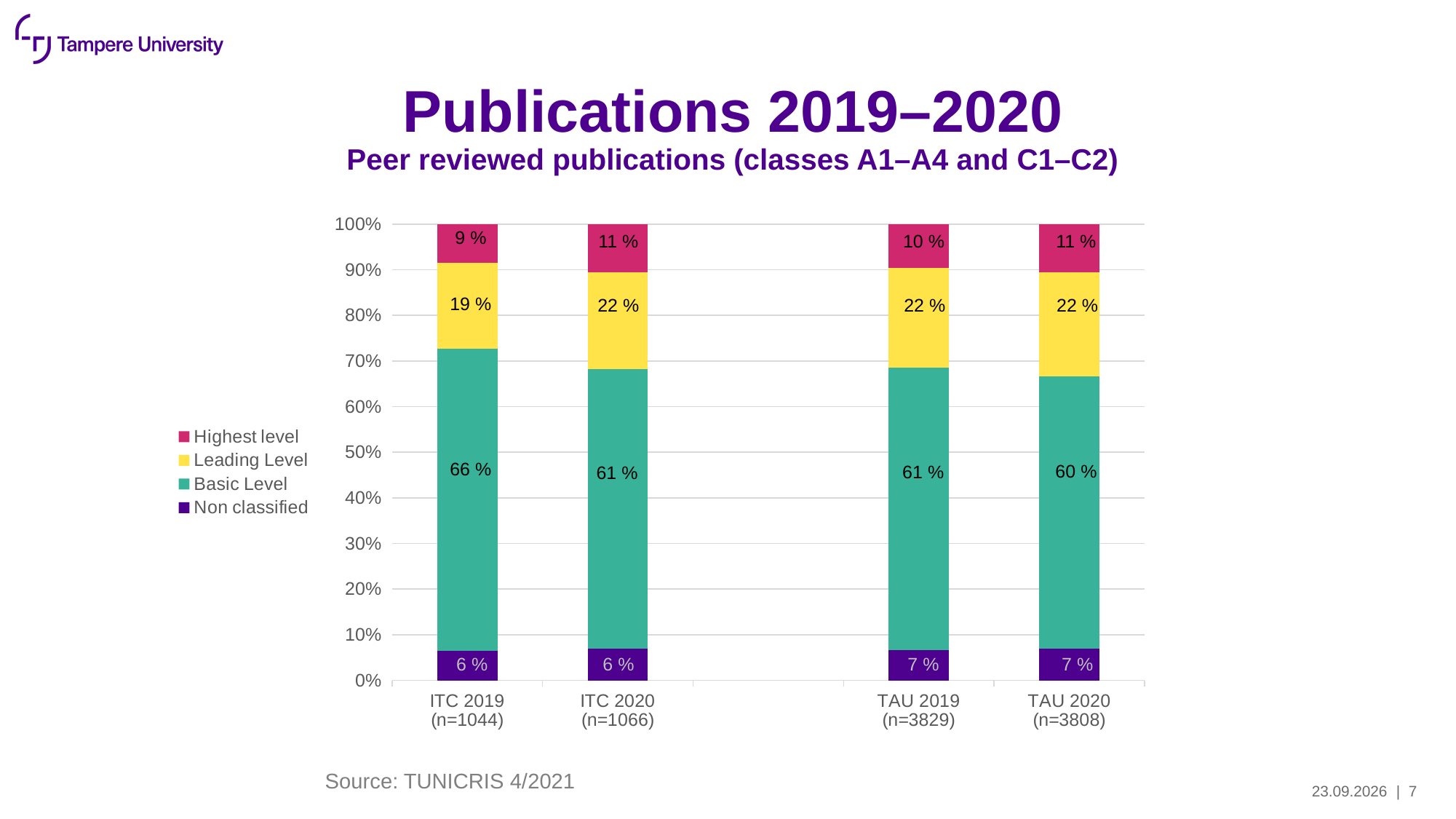
What is the Non classified share for TAU 2019? 7 % What is the difference between the Basic Level share for ITC 2019 and ITC 2020? 5 % Which is larger, the Leading Level share for ITC 2019 or for ITC 2020? ITC 2020 Which category has the lowest Highest level share? ITC 2019 Which category has the highest Basic Level share? ITC 2019 What is the Basic Level share for ITC 2019? 66 % How many series does the legend list? 4 What is the sample size (n) shown for TAU 2019? 3829 What is the Highest level share for TAU 2020? 11 % What kind of chart is shown on the slide? Stacked bar chart How many categories are shown on the x axis? 4 What is the Leading Level share for ITC 2019? 19 %